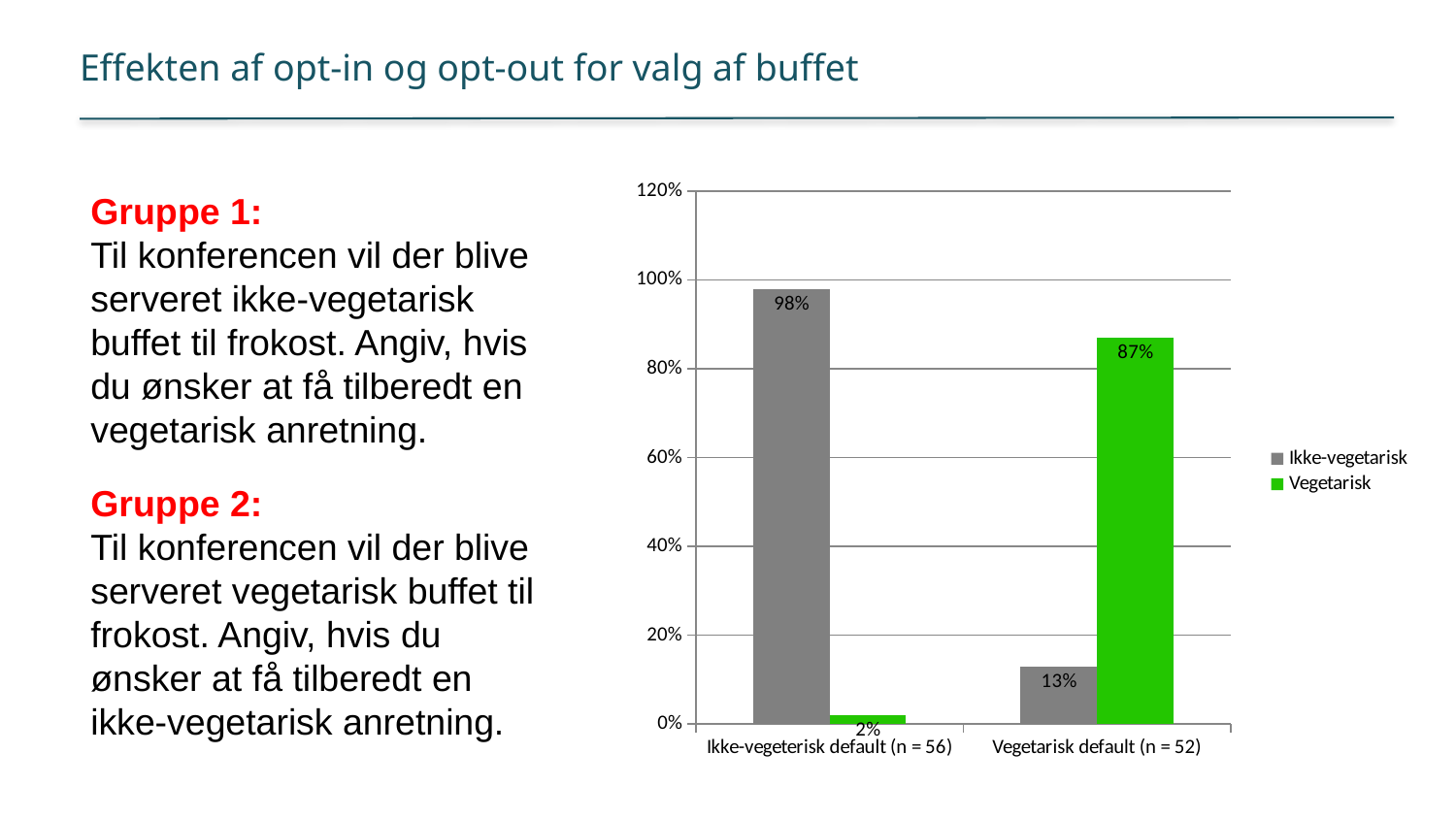
What is the difference between the Vegetarisk values in the Vegetarisk default (n = 52) and Ikke-vegeterisk default (n = 56) categories? 85% Which bar has the highest value in the chart? Ikke-vegetarisk in Ikke-vegeterisk default (n = 56) Which is larger: Ikke-vegetarisk in Ikke-vegeterisk default (n = 56) or Vegetarisk in Vegetarisk default (n = 52)? Ikke-vegetarisk in Ikke-vegeterisk default (n = 56) What is the value for Vegetarisk in the Vegetarisk default (n = 52) category? 87% Which bar has the lowest value in the chart? Vegetarisk in Ikke-vegeterisk default (n = 56) What is the value for Ikke-vegetarisk in the Ikke-vegeterisk default (n = 56) category? 98% How many categories are shown on the x axis of the chart? 2 What is the value for Vegetarisk in the Ikke-vegeterisk default (n = 56) category? 2% What is the value for Ikke-vegetarisk in the Vegetarisk default (n = 52) category? 13% What kind of chart is shown on the slide? Bar chart How many series does the legend list? 2 What colour are the Vegetarisk bars in the chart? Green